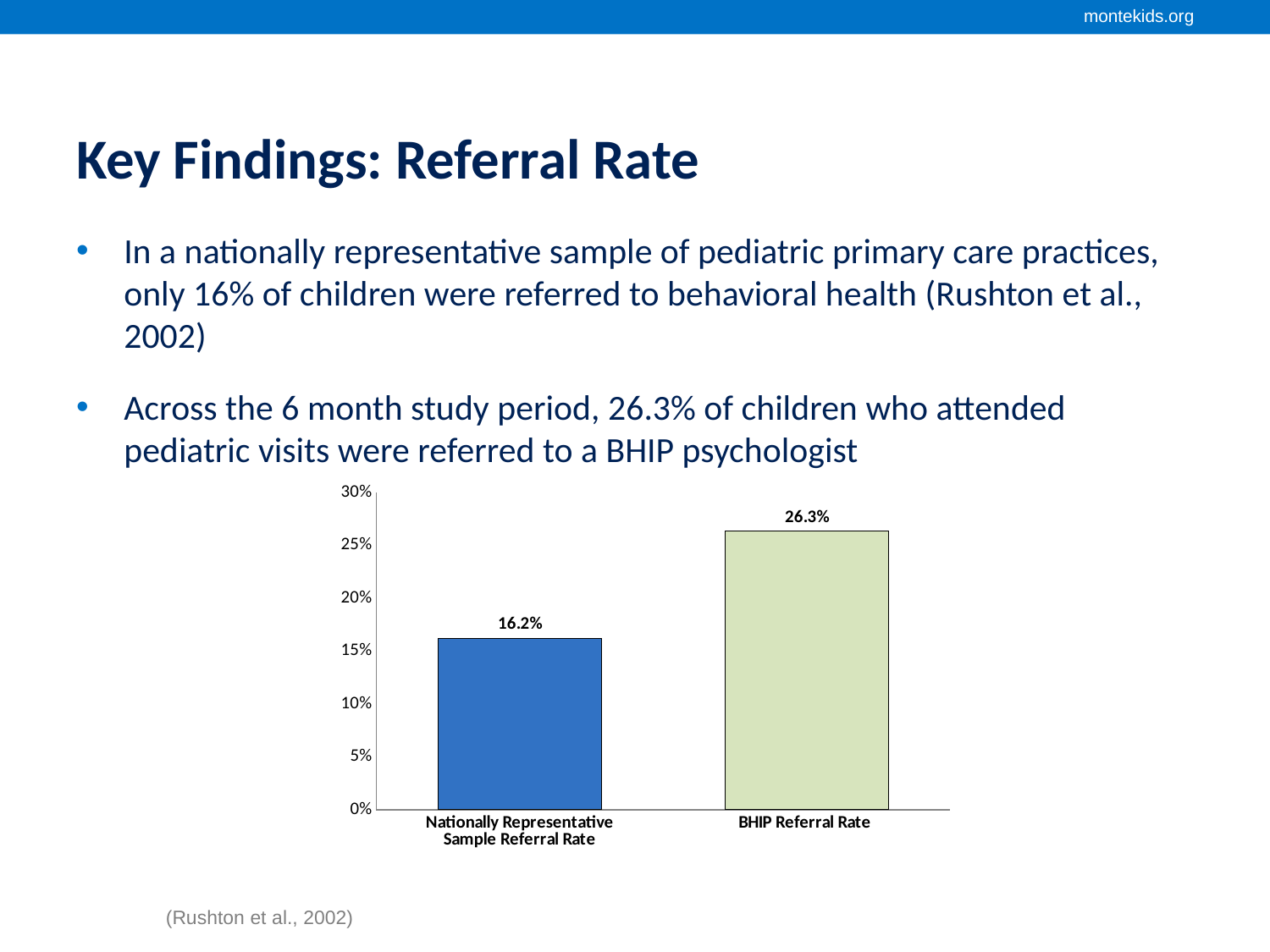
Is the value for BHIP Referral Rate greater or less than 25%? greater Which category has the highest value? BHIP Referral Rate What kind of chart is shown on the slide? Bar chart What is the value for Nationally Representative Sample Referral Rate? 16.2% What is the value for BHIP Referral Rate? 26.3% Which is larger, the BHIP Referral Rate or the Nationally Representative Sample Referral Rate? BHIP Referral Rate Is the value for Nationally Representative Sample Referral Rate greater or less than 20%? less Which category has the lowest value? Nationally Representative Sample Referral Rate What is the difference between the BHIP Referral Rate and the Nationally Representative Sample Referral Rate? 10.1% How many categories are shown in the chart? 2 What is the highest value shown on the vertical axis? 30% What colour is the bar for BHIP Referral Rate? Light green